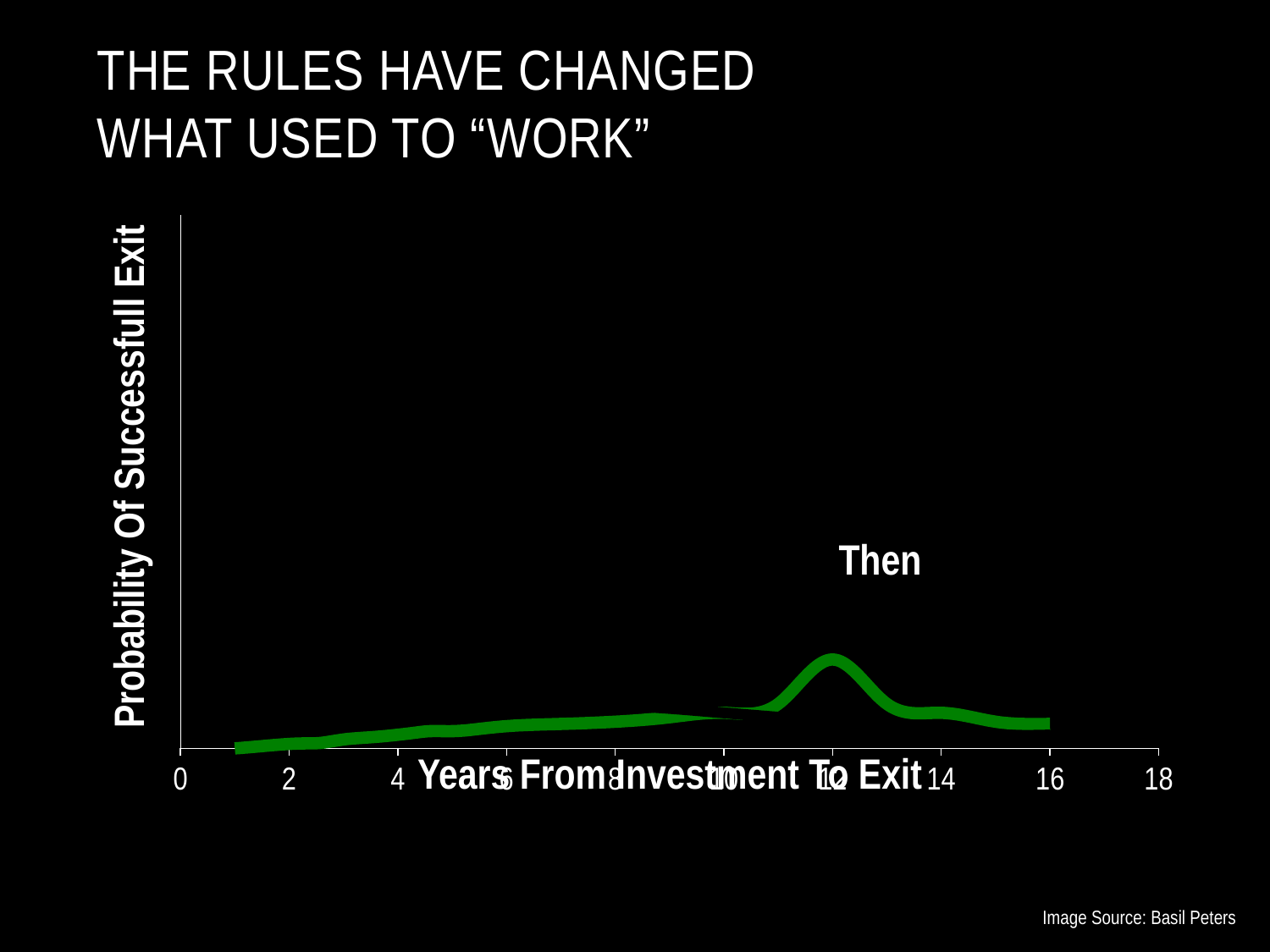
Does the green line rise or fall between 10 and 12 years on the x axis? rise Is the value of the green line at 16 years greater or less than its value at 12 years? less Is the value of the green line at 12 years greater or less than its value at 4 years? greater Does the green line rise or fall between 12 and 14 years on the x axis? fall What is the label on the x axis of the chart? Years From Investment To Exit What is the label on the y axis of the chart? Probability Of Successfull Exit What kind of chart is shown on the slide? line chart At which value on the x axis does the green line reach its highest point? 12 What is the highest value shown on the x axis? 18 How many tick labels are shown on the x axis? 10 What is the lowest value shown on the x axis? 0